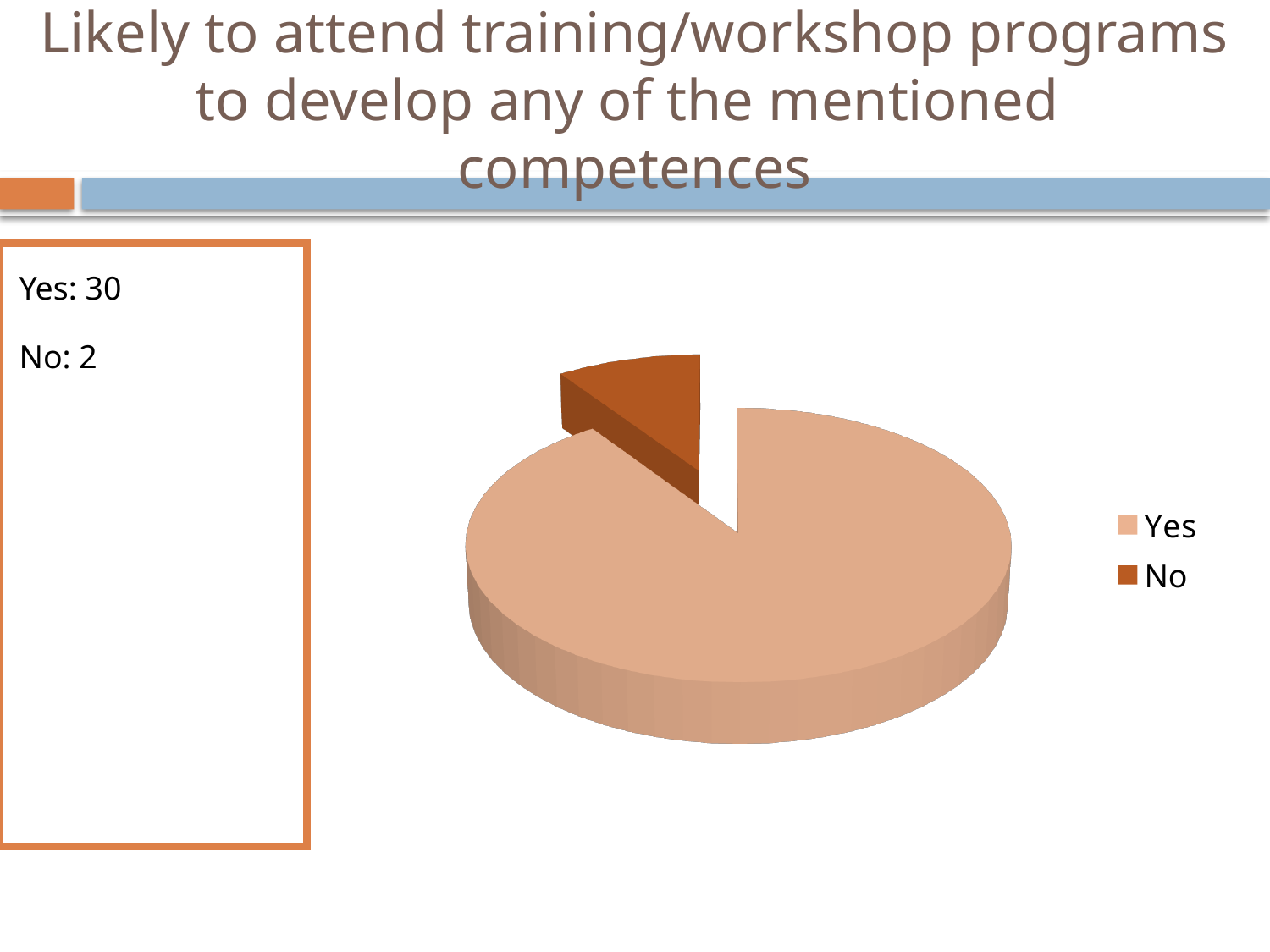
What is the value for No shown on the slide? 2 What is the difference between the Yes and No values? 28 Which category has the smallest slice of the pie chart? No Which slice is larger, Yes or No? Yes What is the value for Yes shown on the slide? 30 How many slices does the pie chart have? 2 How many entries does the legend of the pie chart list? 2 Which category has the largest slice of the pie chart? Yes What is the total of the Yes and No values? 32 What kind of chart is shown on the slide? pie chart Which legend entry is shown in the darker orange-brown colour? No